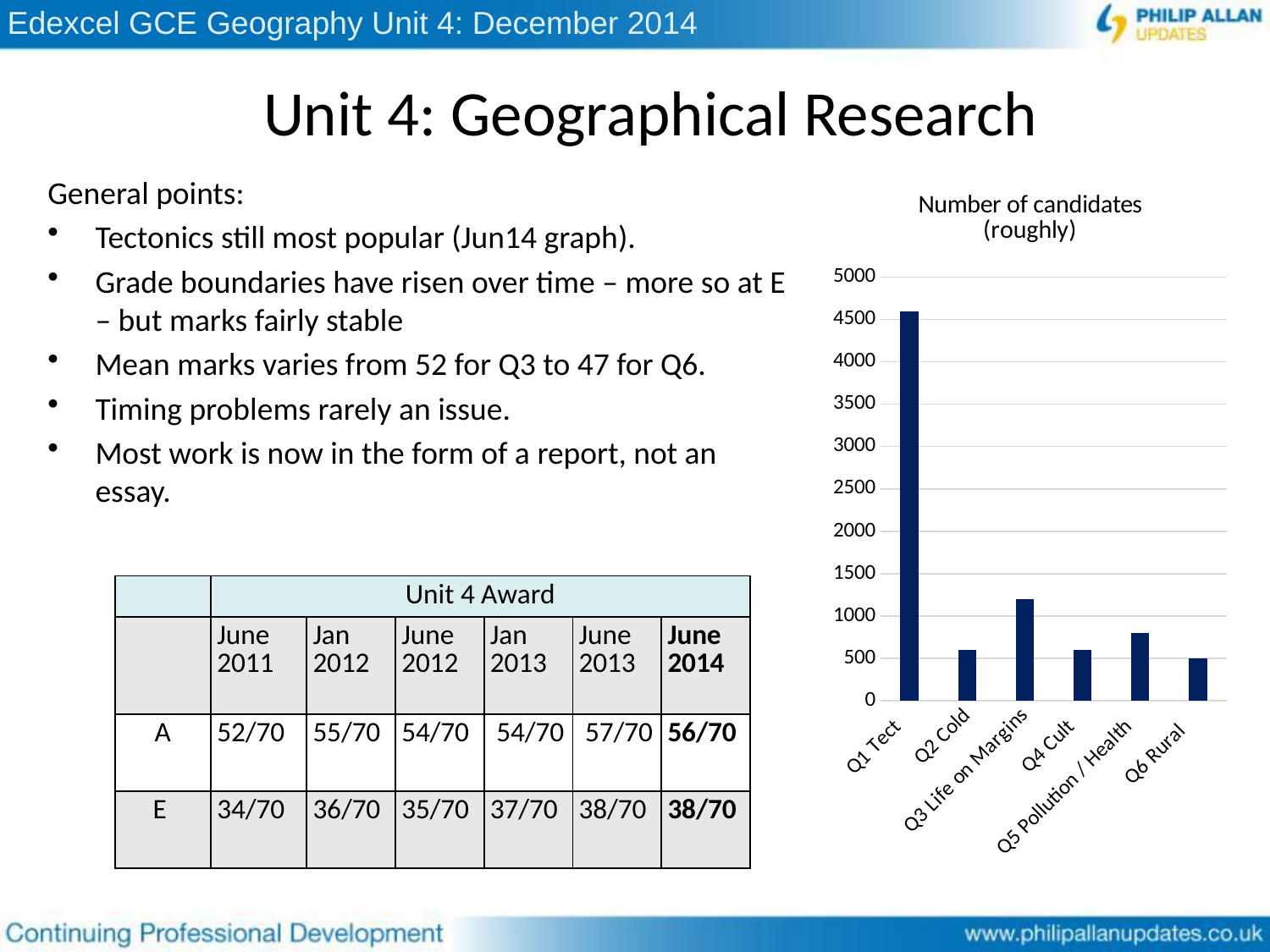
How many categories are plotted on the chart? 6 Which category has the highest number of candidates? Q1 Tect Which has more candidates, Q1 Tect or Q3 Life on Margins? Q1 Tect Is the value for Q5 Pollution / Health greater or less than 1000? less What is the title of the chart? Number of candidates (roughly) Is the value for Q2 Cold greater or less than 1500? less What is the highest value shown on the chart's vertical axis? 5000 Is the value for Q3 Life on Margins greater or less than 1000? greater What kind of chart is shown on the slide? bar chart Which has more candidates, Q3 Life on Margins or Q5 Pollution / Health? Q3 Life on Margins